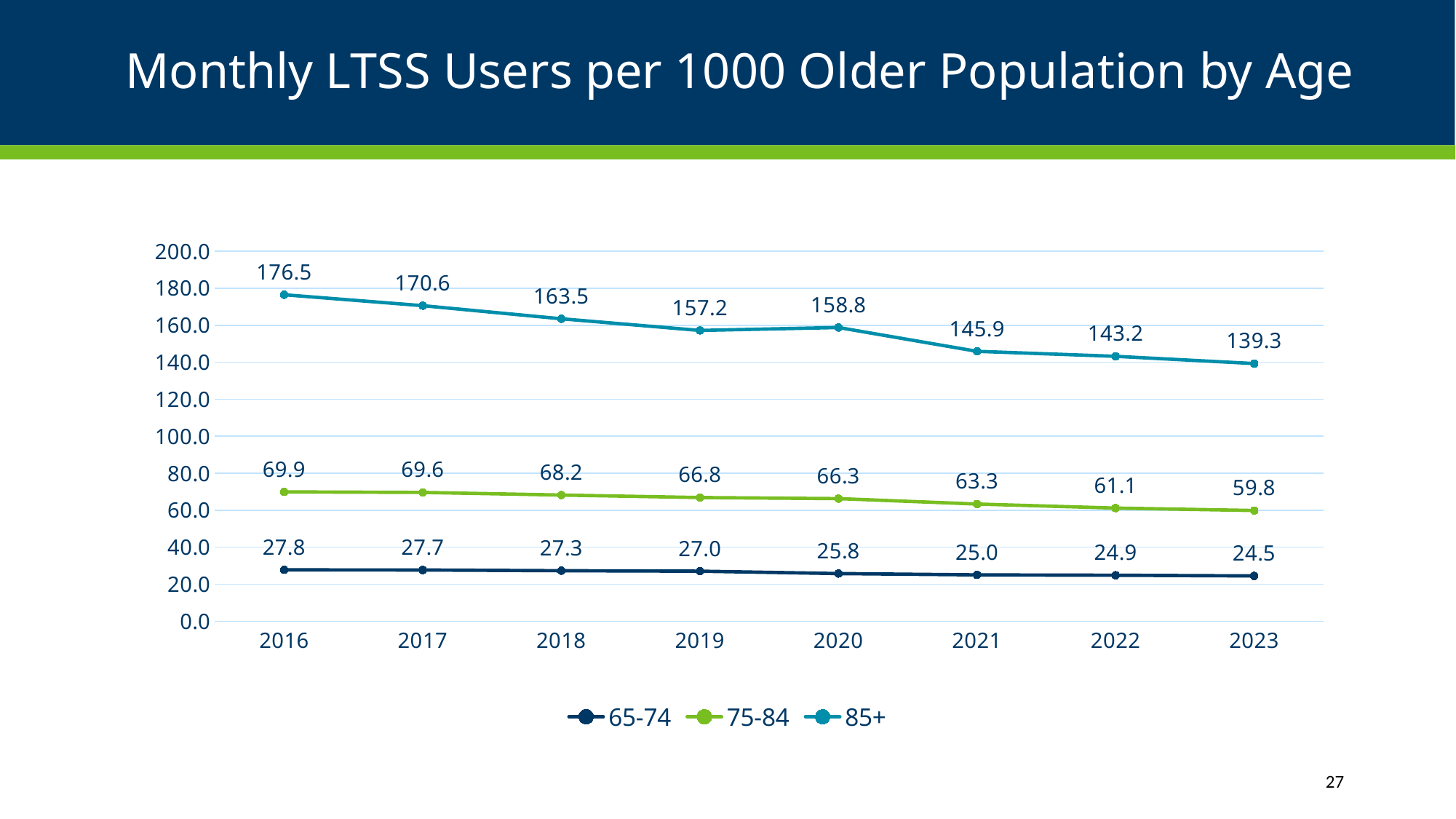
What is the value for the 75-84 series in 2020? 66.3 In which year is the 85+ series at its lowest? 2023 What is the difference between the 85+ value in 2016 and in 2023? 37.2 What is the value for the 85+ series in 2016? 176.5 Which is larger, the 85+ value in 2019 or in 2020? 2020 Is the 85+ value in 2021 greater or less than 160? less How many series does the legend list? 3 Does the 65-74 series rise or fall from 2016 to 2023? fall In which year is the 75-84 series at its highest? 2016 How many years are shown on the x axis? 8 What kind of chart is shown on the slide? line chart What is the value for the 65-74 series in 2023? 24.5